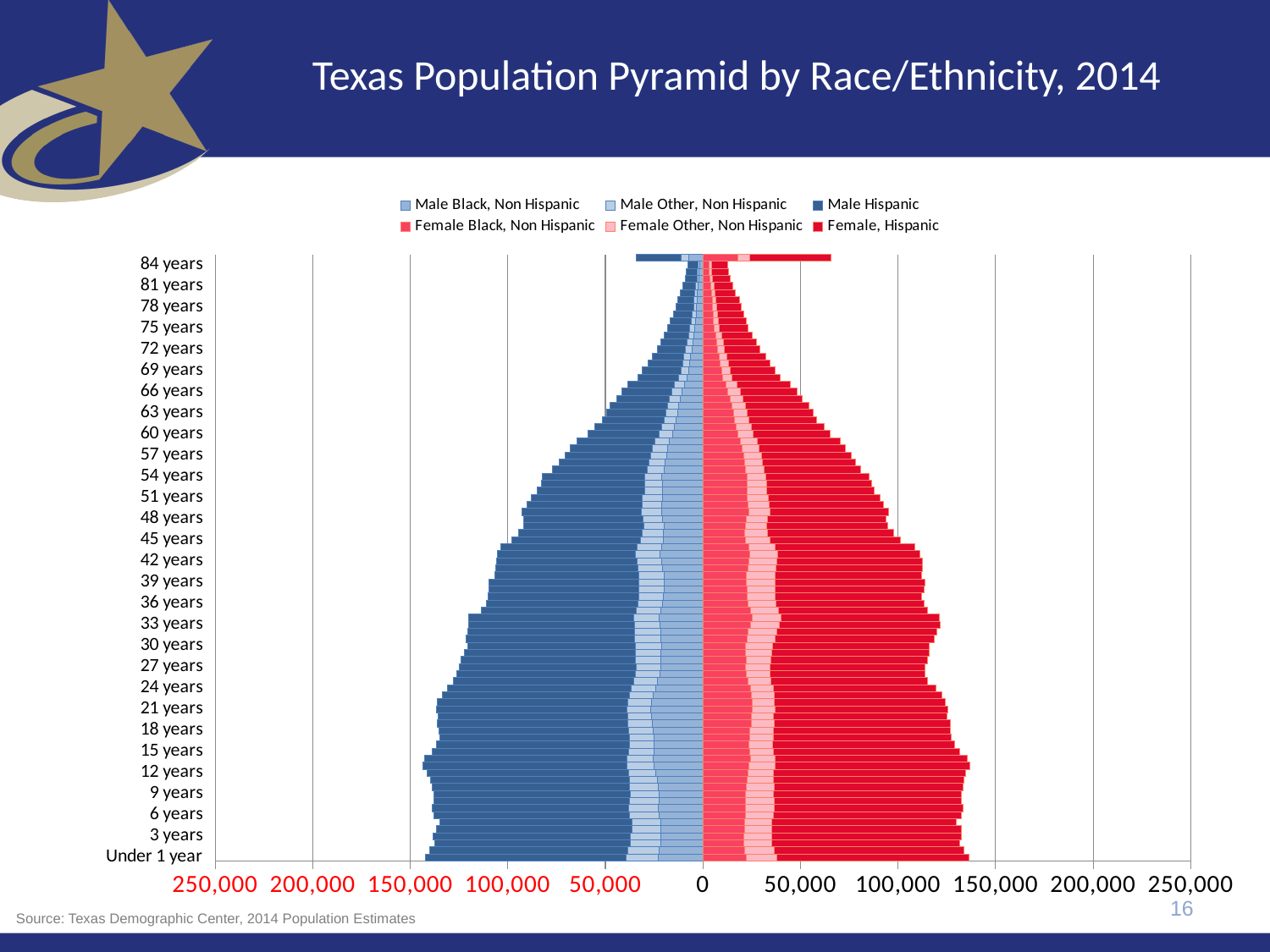
Which is larger at 33 years: the Female Hispanic segment or the Female Black, Non Hispanic segment? Female Hispanic Do the bar lengths generally rise or fall as age increases from Under 1 year to 84 years? fall How many series does the legend list? 6 Which legend entry is shown in dark blue? Male Hispanic Is the total female population for 84 years greater or less than 100,000? less What is the title of the chart? Texas Population Pyramid by Race/Ethnicity, 2014 Which age group has a larger total male population: 12 years or 84 years? 12 years Is the total female population for Under 1 year greater or less than 100,000? greater What kind of chart is shown on the slide? Bar chart (population pyramid) Which is larger at 12 years: the Male Hispanic segment or the Male Other, Non Hispanic segment? Male Hispanic Is the total male population for 12 years greater or less than 100,000? greater